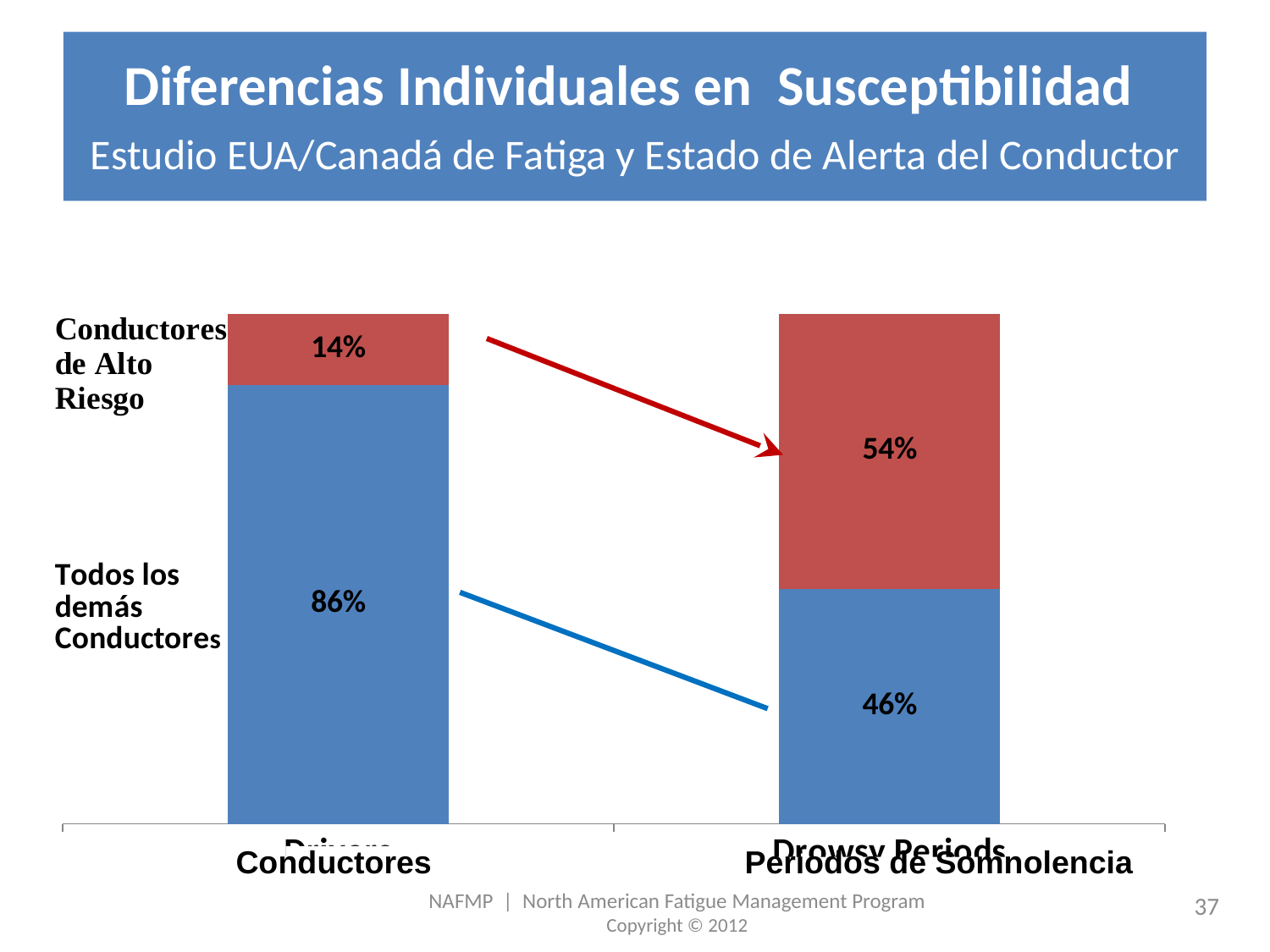
What is the value for Todos los demás Conductores in the Periodos de Somnolencia bar? 46% What is the value for Conductores de Alto Riesgo in the Periodos de Somnolencia bar? 54% What is the value for Conductores de Alto Riesgo in the Conductores bar? 14% How many series are stacked in each bar? 2 What colour represents Conductores de Alto Riesgo in the chart? red Which is larger: the Conductores de Alto Riesgo share in Conductores or in Periodos de Somnolencia? Periodos de Somnolencia What kind of chart is shown on the slide? stacked bar chart In which category is the Todos los demás Conductores share highest? Conductores What is the value for Todos los demás Conductores in the Conductores bar? 86% What is the difference between the Conductores de Alto Riesgo share in Periodos de Somnolencia and in Conductores? 40% What is the total of the Periodos de Somnolencia stacked bar? 100% How many bars (categories) are shown on the x axis? 2